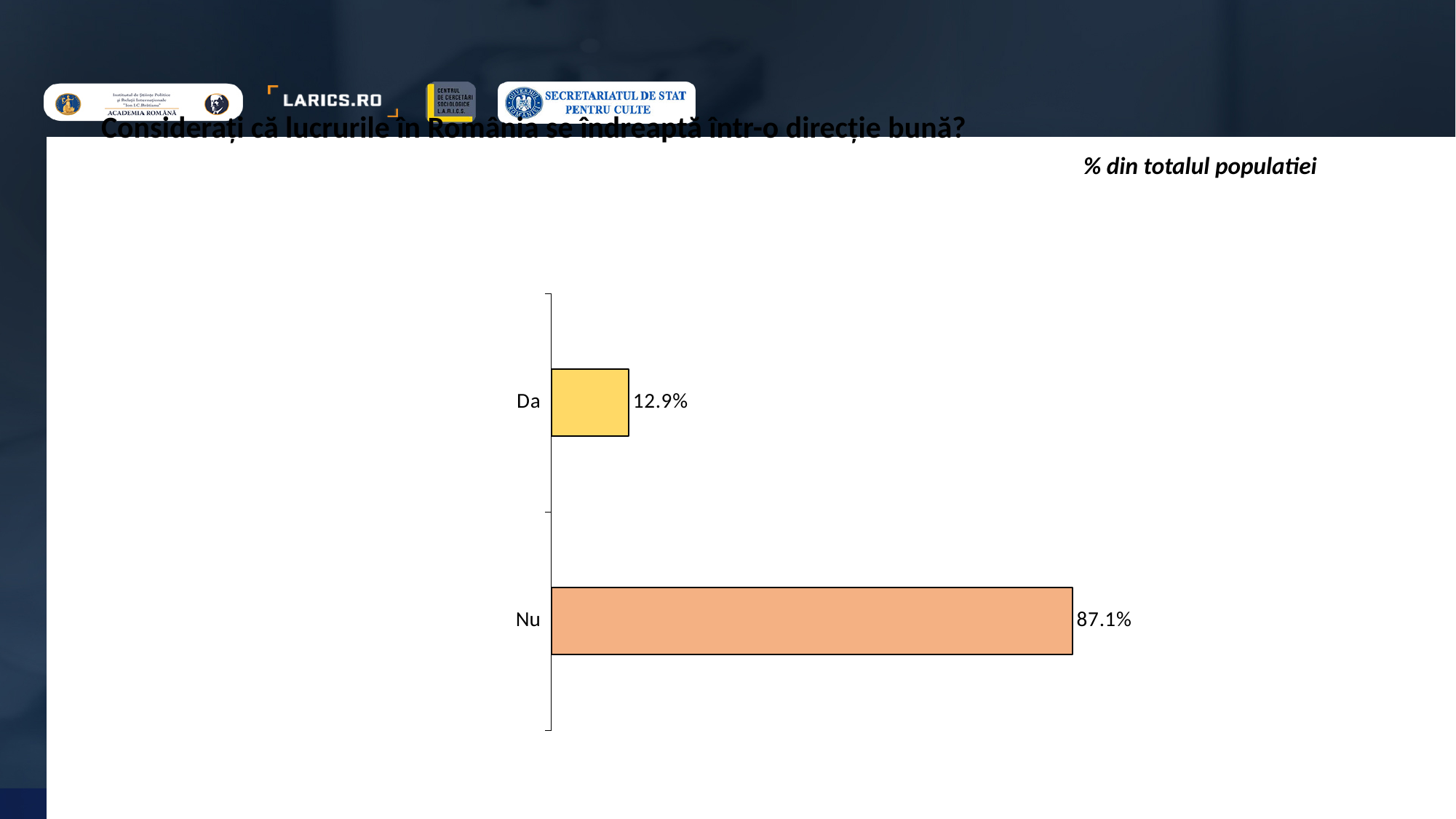
Which category has the highest value? Nu What is the total of the values for "Da" and "Nu"? 100% What is the value for "Da"? 12.9% What colour is the bar for "Nu"? Orange Which is larger, the value for "Da" or the value for "Nu"? Nu What is the value for "Nu"? 87.1% What is the difference between the values for "Nu" and "Da"? 74.2% How many categories are shown in the chart? 2 Which category has the lowest value? Da What kind of chart is shown on the slide? Bar chart What unit note is shown above the chart? % din totalul populatiei